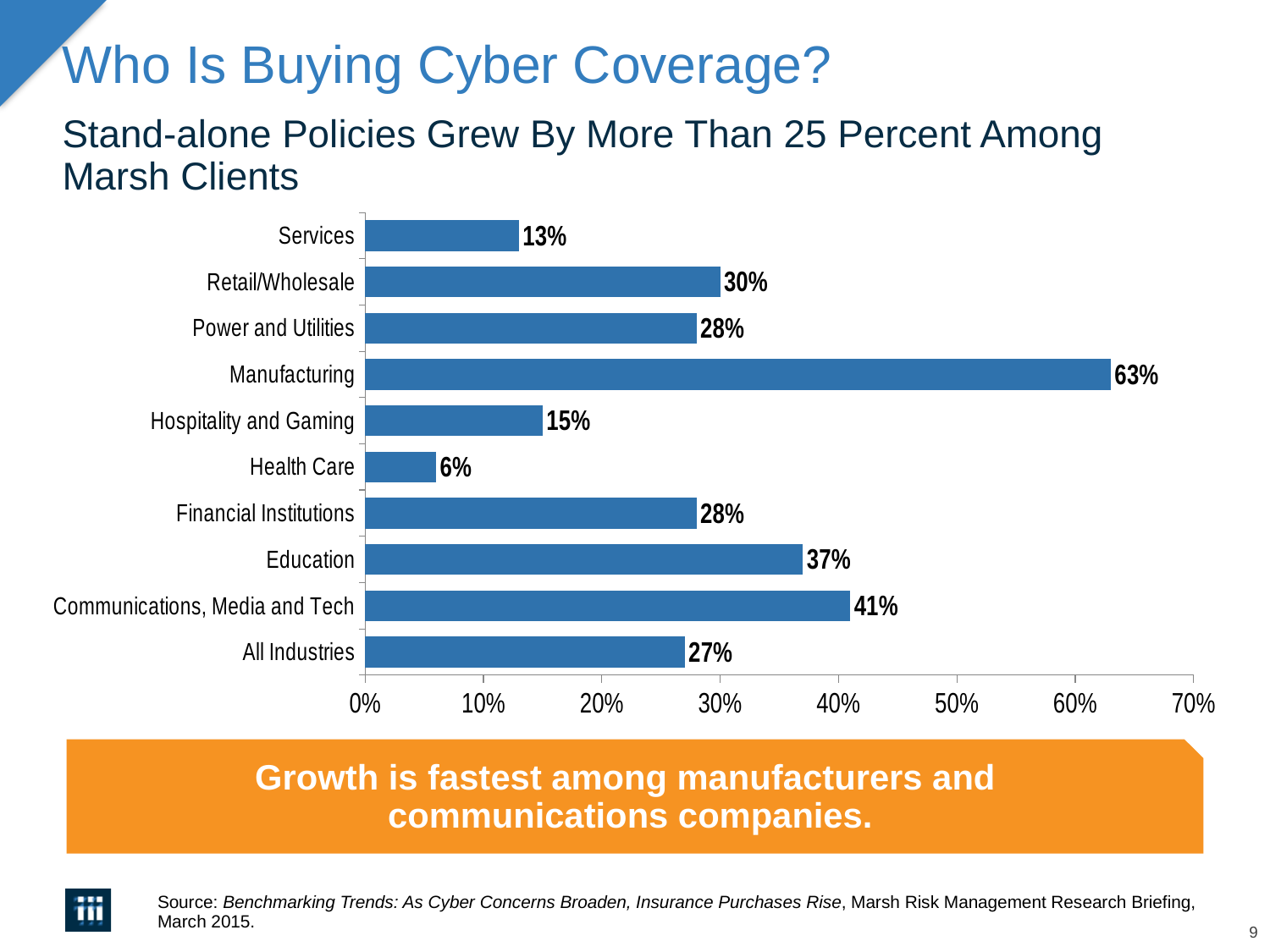
What is the value for Manufacturing? 63% What is the highest value shown on the x axis? 70% What is the difference between the values for Manufacturing and Education? 26% Which category has the highest value? Manufacturing How many categories are shown in the chart? 10 Which is larger, the value for Education or the value for Hospitality and Gaming? Education What is the value for Health Care? 6% What is the difference between the values for Retail/Wholesale and Services? 17% What kind of chart is shown on the slide? Bar chart What is the value for Communications, Media and Tech? 41% Which category has the lowest value? Health Care What is the value for All Industries? 27%